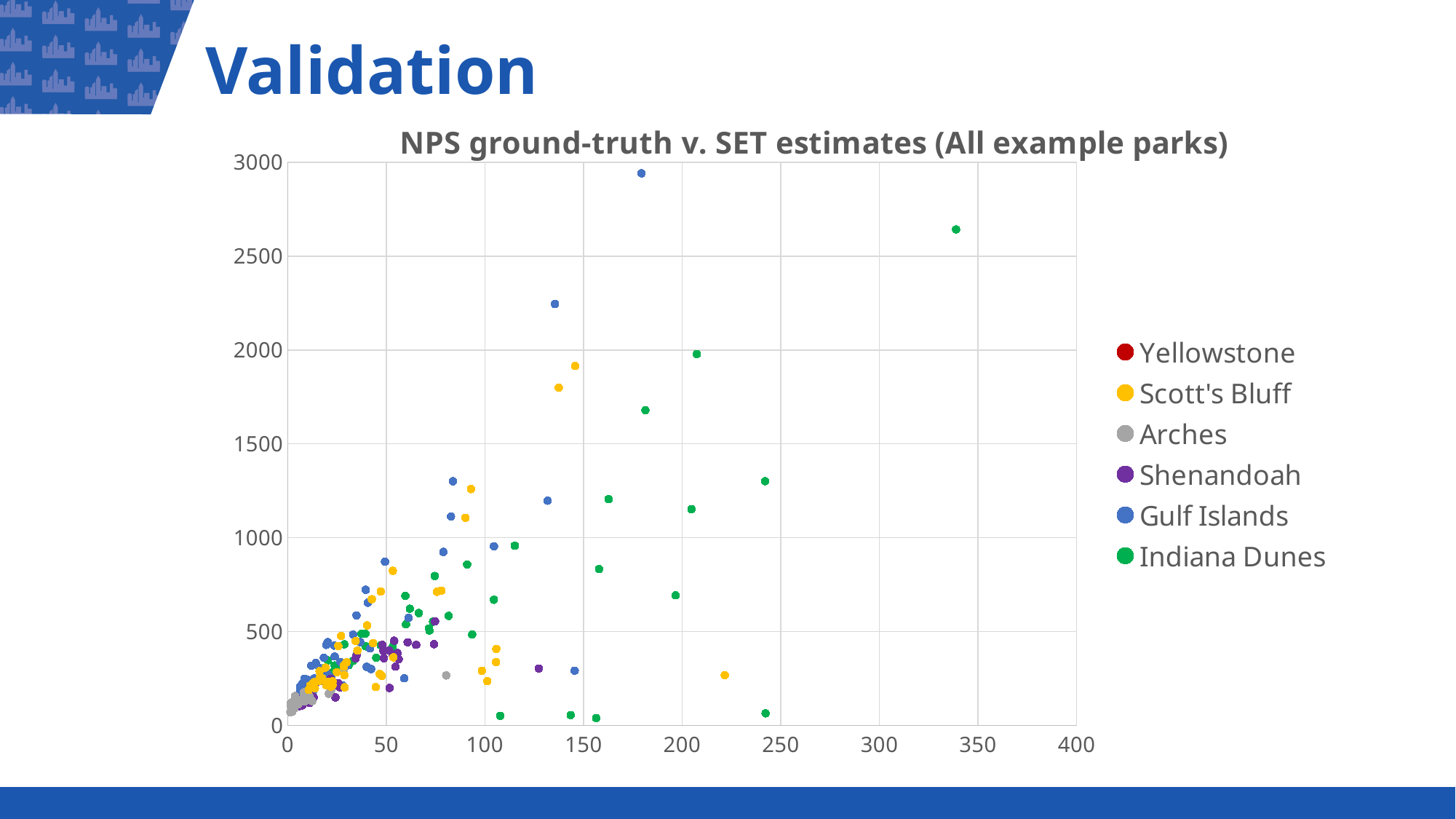
Is the y value of the highest Indiana Dunes point greater or less than 2500? greater Is the x value of the rightmost Indiana Dunes point greater or less than 300? greater Which series has the higher top point, Gulf Islands or Scott's Bluff? Gulf Islands Which series has the highest point on the chart? Gulf Islands Which series is plotted in green? Indiana Dunes What kind of chart is shown on the slide? Scatter chart What is the title of the chart? NPS ground-truth v. SET estimates (All example parks) Is the y value of the highest Gulf Islands point greater or less than 2500? greater Which series has the point farthest to the right on the x axis? Indiana Dunes How many series does the chart's legend list? 6 What is the maximum value shown on the y axis? 3000